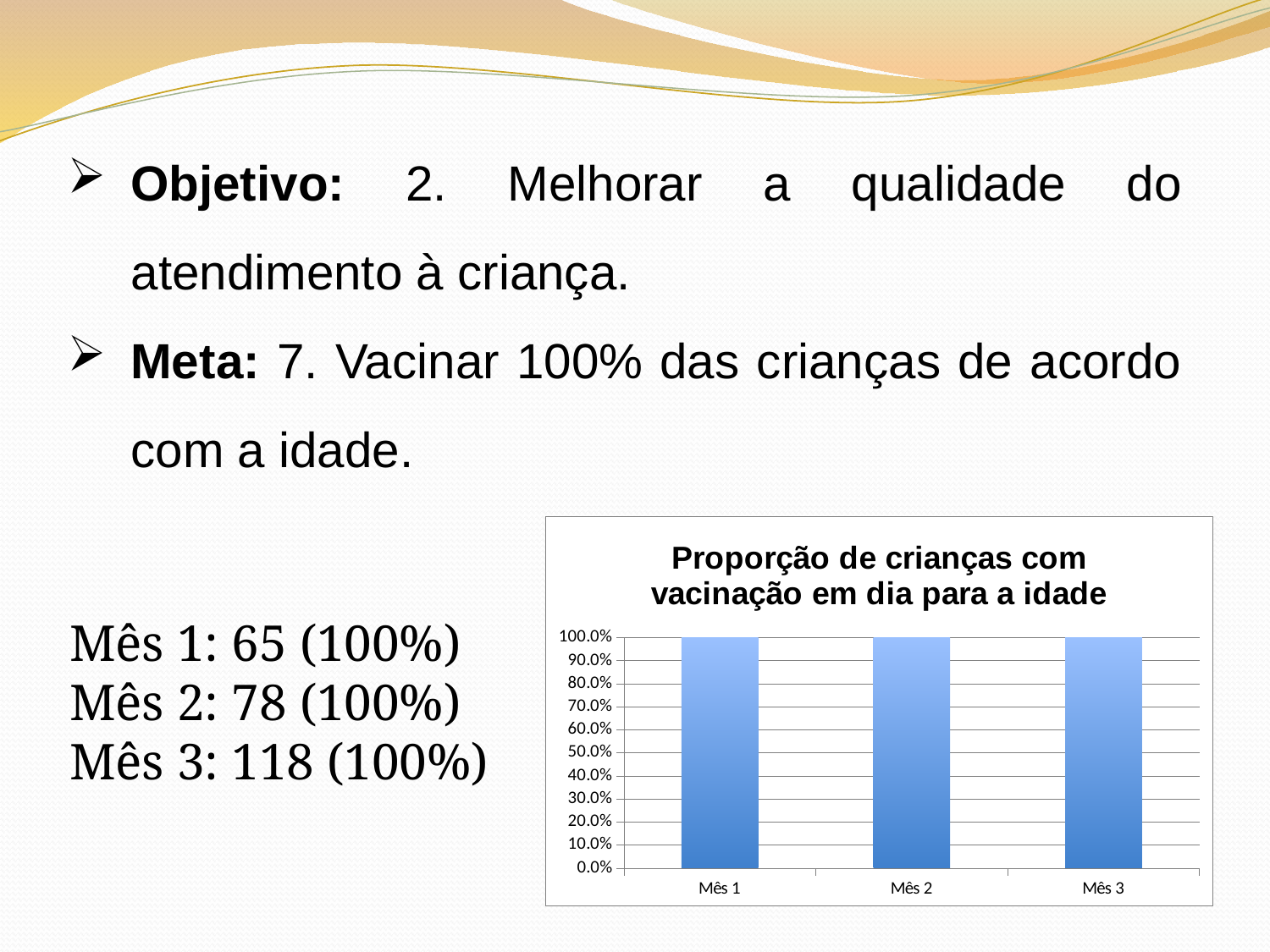
Is the value for Mês 3 greater or less than 90.0%? greater Is the value for Mês 2 greater or less than 50.0%? greater What value does the bar for Mês 3 reach on the y axis? 100.0% What is the highest tick value shown on the y axis? 100.0% What is the difference between the values for Mês 1 and Mês 3? 0.0% What kind of chart is shown on the slide? bar chart What value does the bar for Mês 1 reach on the y axis? 100.0% What is the label of the first category on the x axis? Mês 1 Do the values rise, fall or stay the same from Mês 1 to Mês 3? stay the same How many categories are plotted on the x axis of the chart? 3 What value does the bar for Mês 2 reach on the y axis? 100.0% What is the title of the chart? Proporção de crianças com vacinação em dia para a idade